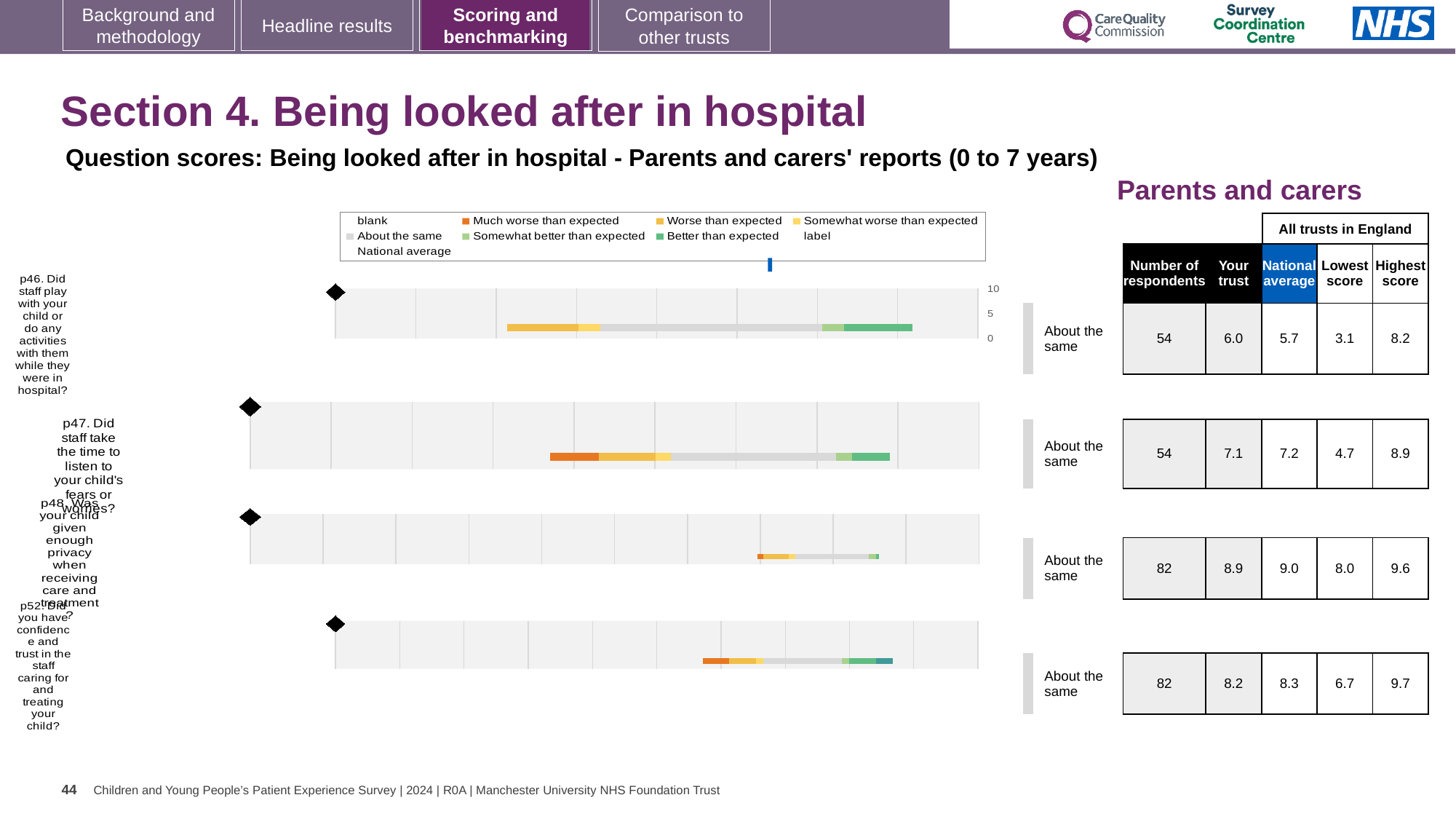
How many respondents answered p52 (Did you have confidence and trust in the staff caring for and treating your child?)? 82 Which question has the lowest 'Your trust' score? p46 Which question has the highest 'Your trust' score? p48 What is the lowest score across all trusts in England for p47? 4.7 For p52, which is larger: the 'Your trust' score or the national average? National average What is the national average score for p47 (Did staff take the time to listen to your child's fears or worries?)? 7.2 How many survey questions are plotted in the chart? 4 What is the 'Your trust' score for p46 (Did staff play with your child or do any activities with them while they were in hospital?)? 6.0 What kind of chart is used to show the question scores on this slide? bar chart For p48, what is the difference between the highest score and the lowest score across all trusts in England? 1.6 What heading appears above the table of scores on the right of the slide? Parents and carers What benchmark category is shown for all four questions on this slide? About the same